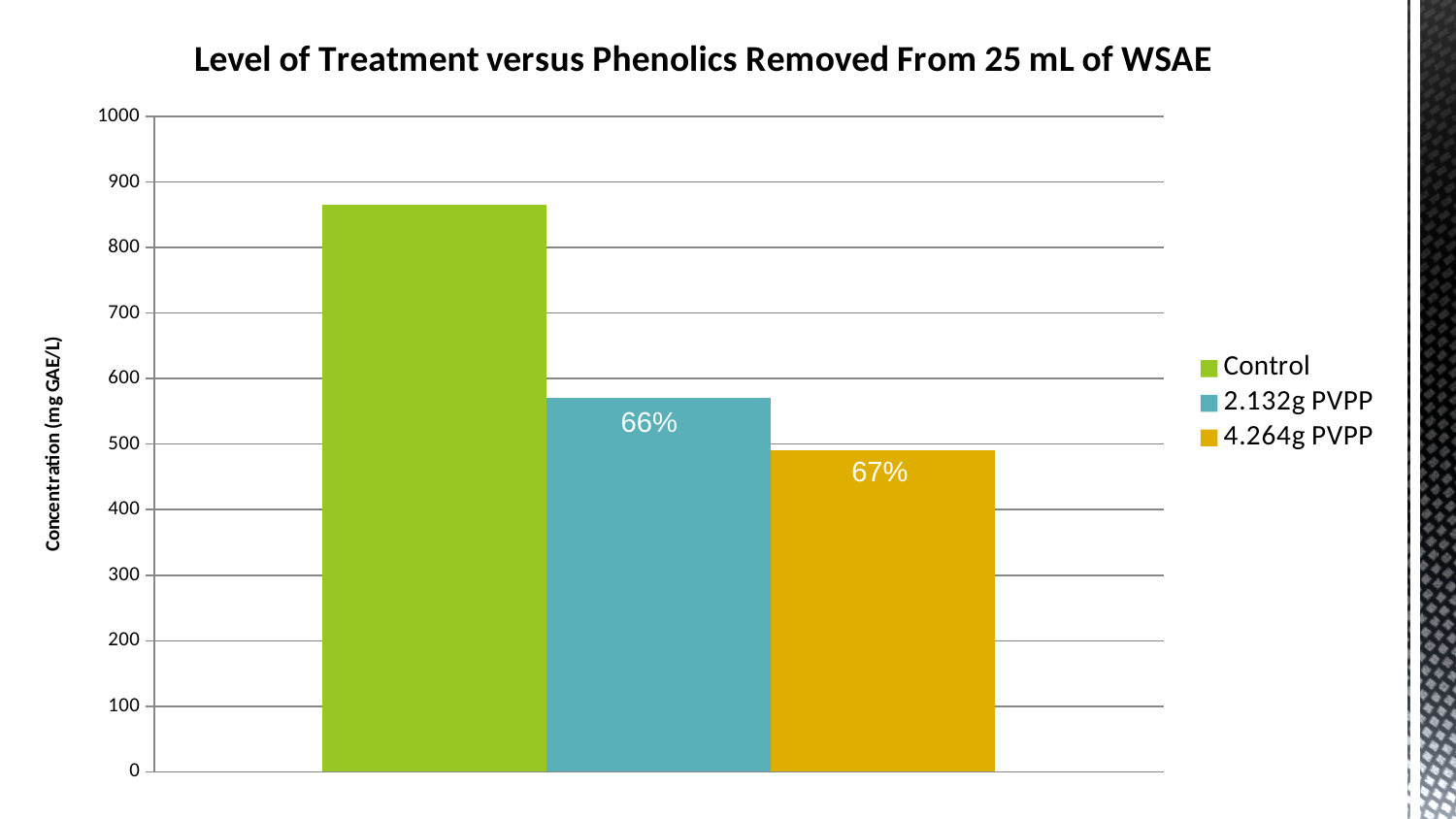
Is the value for 2.132g PVPP greater or less than 600? less How many series does the legend list? 3 Is the value for Control greater or less than 800? greater How many bars are plotted in the chart? 3 What kind of chart is shown on the slide? bar chart What is the label on the vertical axis? Concentration (mg GAE/L) Is the value for Control greater or less than 900? less Which is larger, the concentration for 2.132g PVPP or for 4.264g PVPP? 2.132g PVPP Which series has the highest concentration? Control What is the title of the chart? Level of Treatment versus Phenolics Removed From 25 mL of WSAE Which series has the lowest concentration? 4.264g PVPP